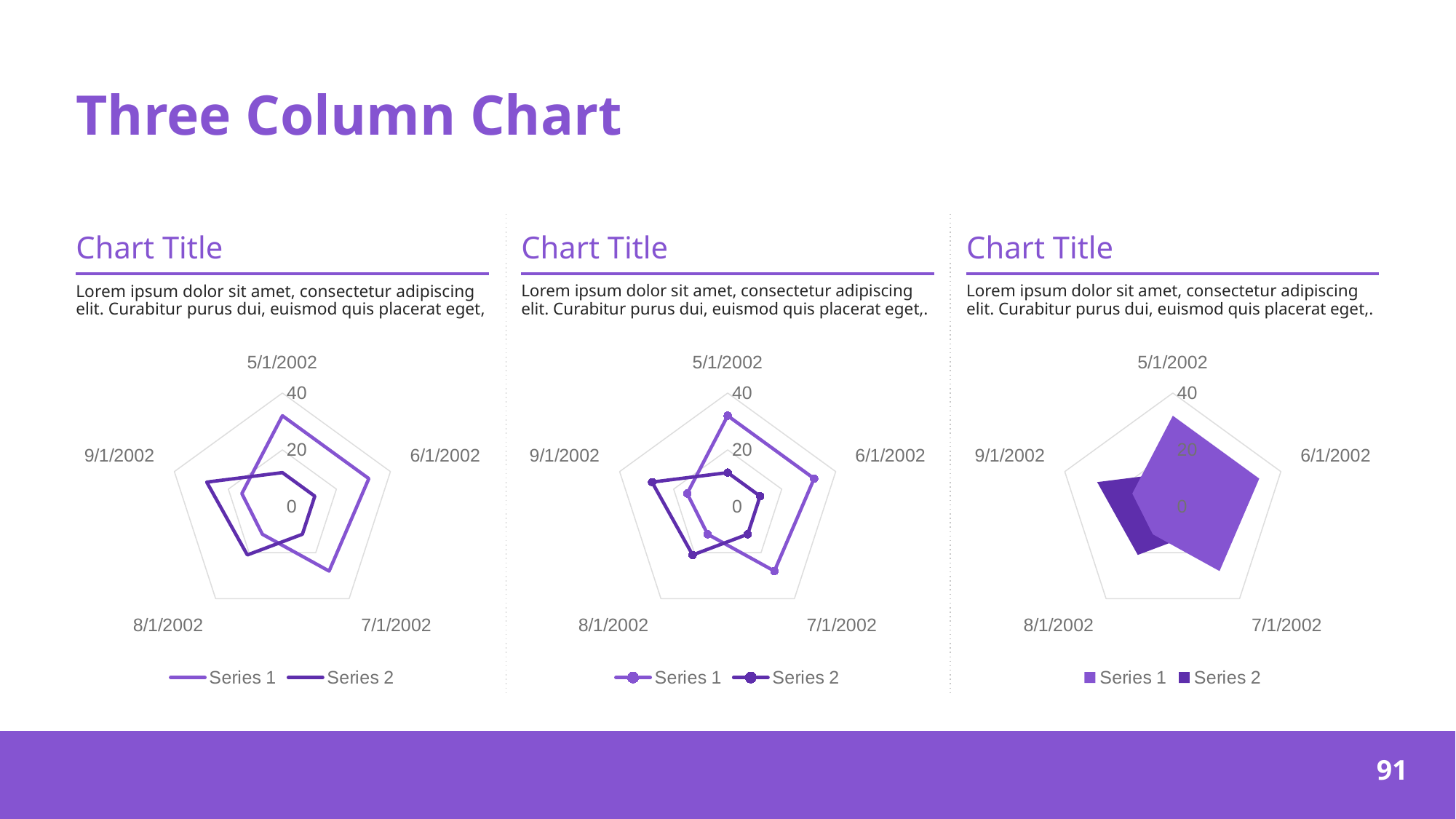
How many series does the legend of the right chart list? 2 In the middle chart, is the value of Series 1 for 8/1/2002 greater or less than 20? less What are the legend entries of the middle chart? Series 1, Series 2 In the right chart, is the value of Series 2 for 9/1/2002 greater or less than 20? greater In the left chart, which series has the larger value for 8/1/2002? Series 2 In the left chart, is the value of Series 2 for 5/1/2002 greater or less than 20? less In the middle chart, which series has the larger value for 6/1/2002? Series 1 How many categories does the middle chart have? 5 What is the highest value shown on the axis of the right chart? 40 What kind of chart is the left chart? Radar chart